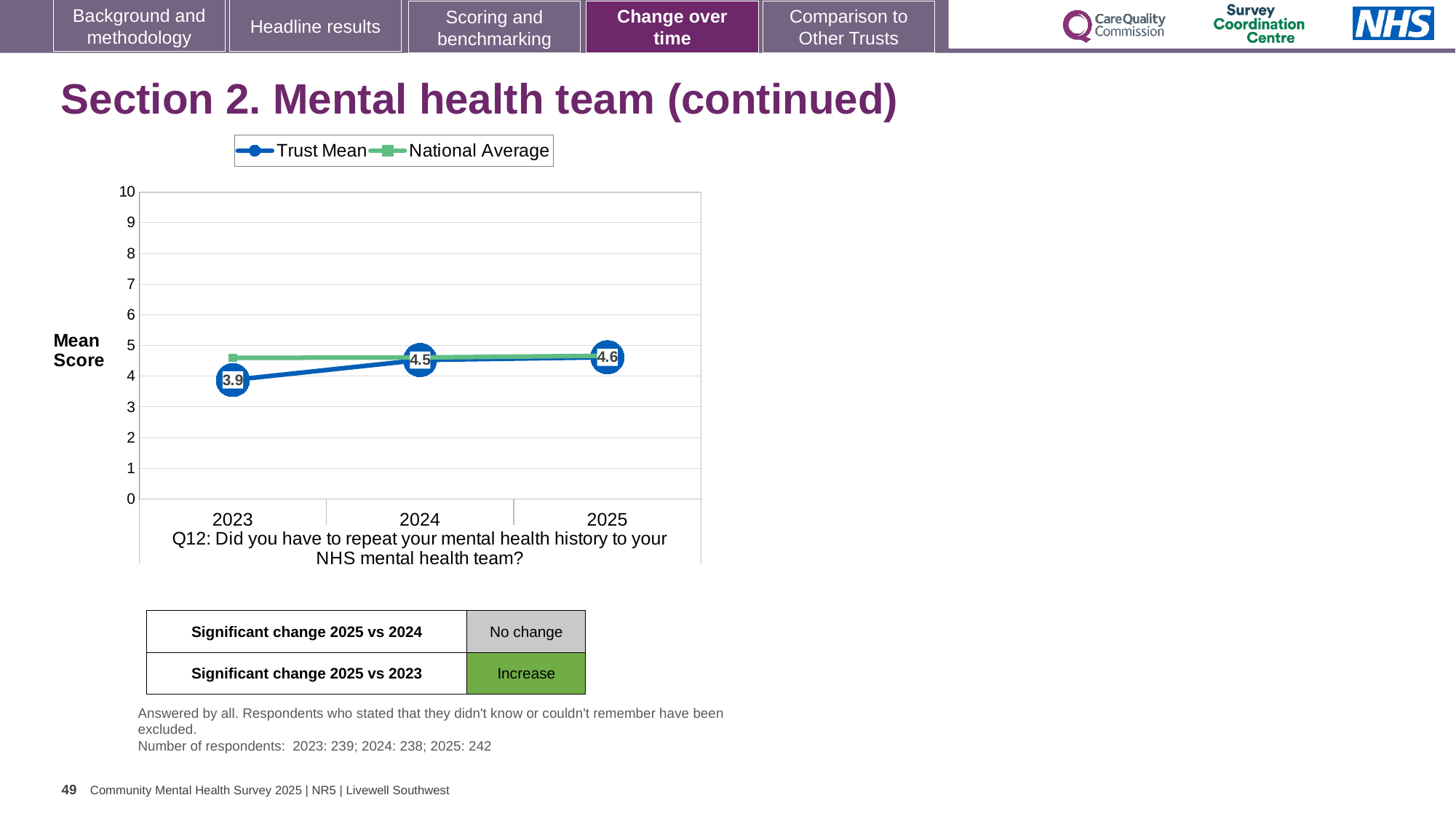
How many series does the chart legend list? 2 How many years are shown on the x axis of the chart? 3 What kind of chart is shown on the slide? Line chart What is the Trust Mean score for 2023? 3.9 In which year is the Trust Mean score highest? 2025 Is the National Average value for 2025 greater or less than 5? less Which is larger in 2023, the Trust Mean or the National Average? National Average What is the difference between the Trust Mean score in 2025 and in 2023? 0.7 What is the Trust Mean score for 2025? 4.6 What is the Trust Mean score for 2024? 4.5 In which year is the Trust Mean score lowest? 2023 Is the National Average value for 2023 greater or less than 4? greater